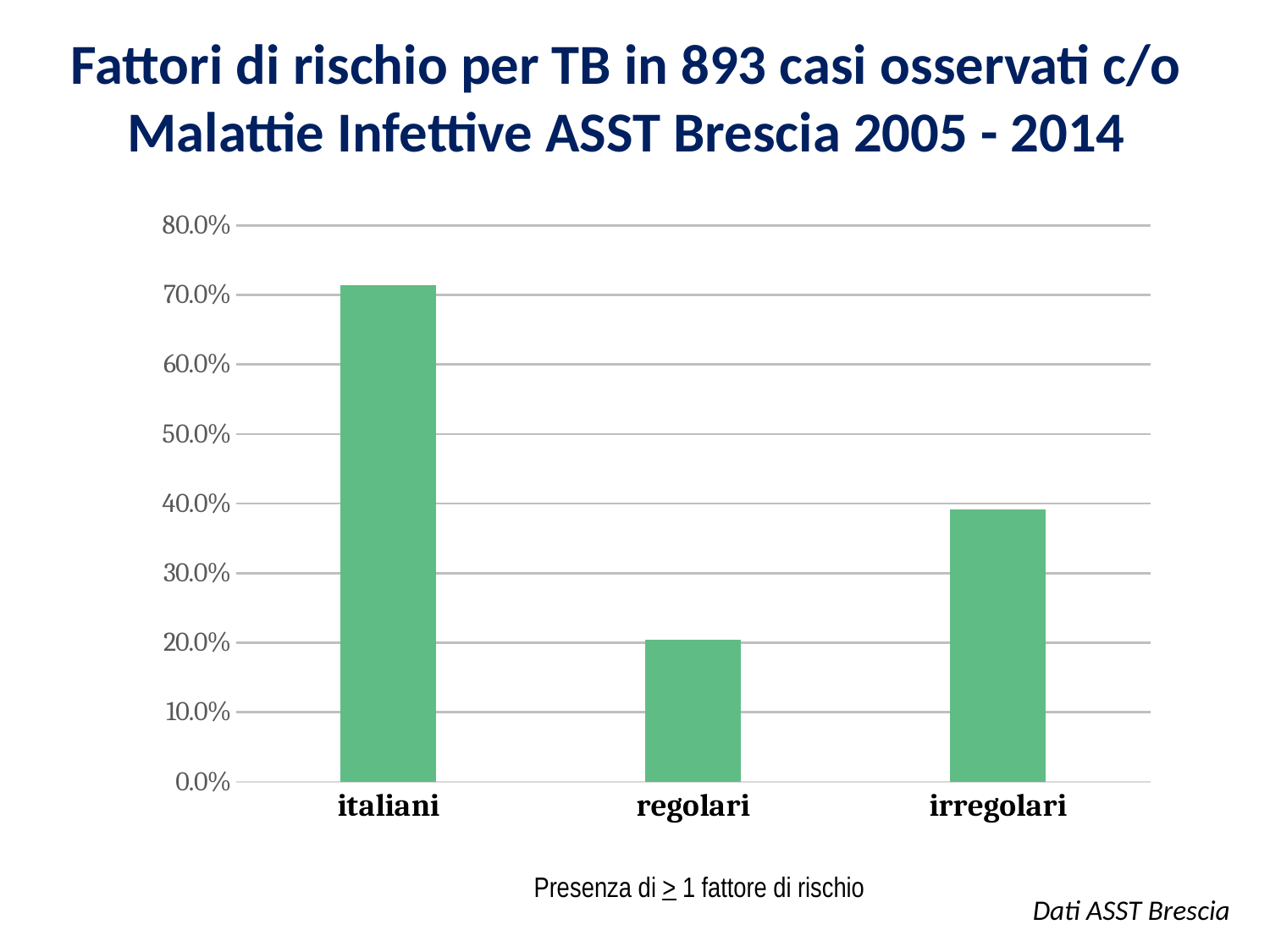
Which category has the highest bar in the chart? italiani Is the value for irregolari greater or less than 50.0%? less What is the caption printed below the x axis of the chart? Presenza di ≥ 1 fattore di rischio Which category has the lowest bar in the chart? regolari Is the value for italiani greater or less than 60.0%? greater What kind of chart is shown on the slide? bar chart Is the value for irregolari greater or less than 30.0%? greater Which is larger, the value for italiani or the value for irregolari? italiani Which is larger, the value for regolari or the value for irregolari? irregolari How many categories are shown on the x axis of the chart? 3